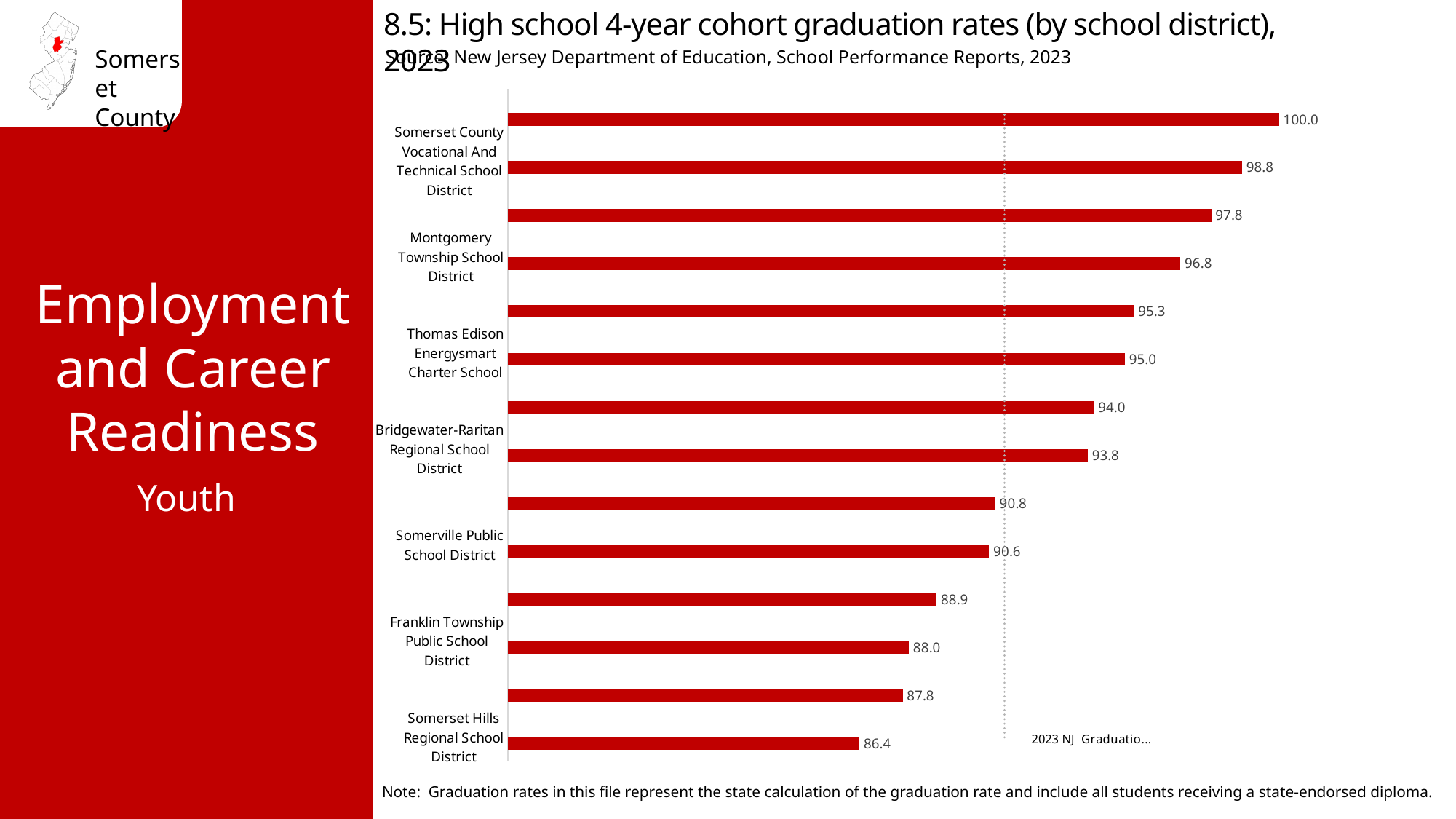
What is the graduation rate for Montgomery Township School District? 96.8 What is the graduation rate for Somerset Hills Regional School District? 86.4 What is the graduation rate for Somerville Public School District? 90.6 How many bars are plotted in the chart? 14 What is the difference between the graduation rates of Montgomery Township School District and Somerset Hills Regional School District? 10.4 Which has a higher graduation rate, Montgomery Township School District or Somerville Public School District? Montgomery Township School District What is the highest graduation rate value shown in the chart? 100.0 What kind of chart is shown on the slide? bar chart What source is cited for the chart data? New Jersey Department of Education, School Performance Reports, 2023 What is the lowest graduation rate value shown in the chart? 86.4 What is the title of the chart? 8.5: High school 4-year cohort graduation rates (by school district), 2023 Which labeled school district has the lowest graduation rate in the chart? Somerset Hills Regional School District